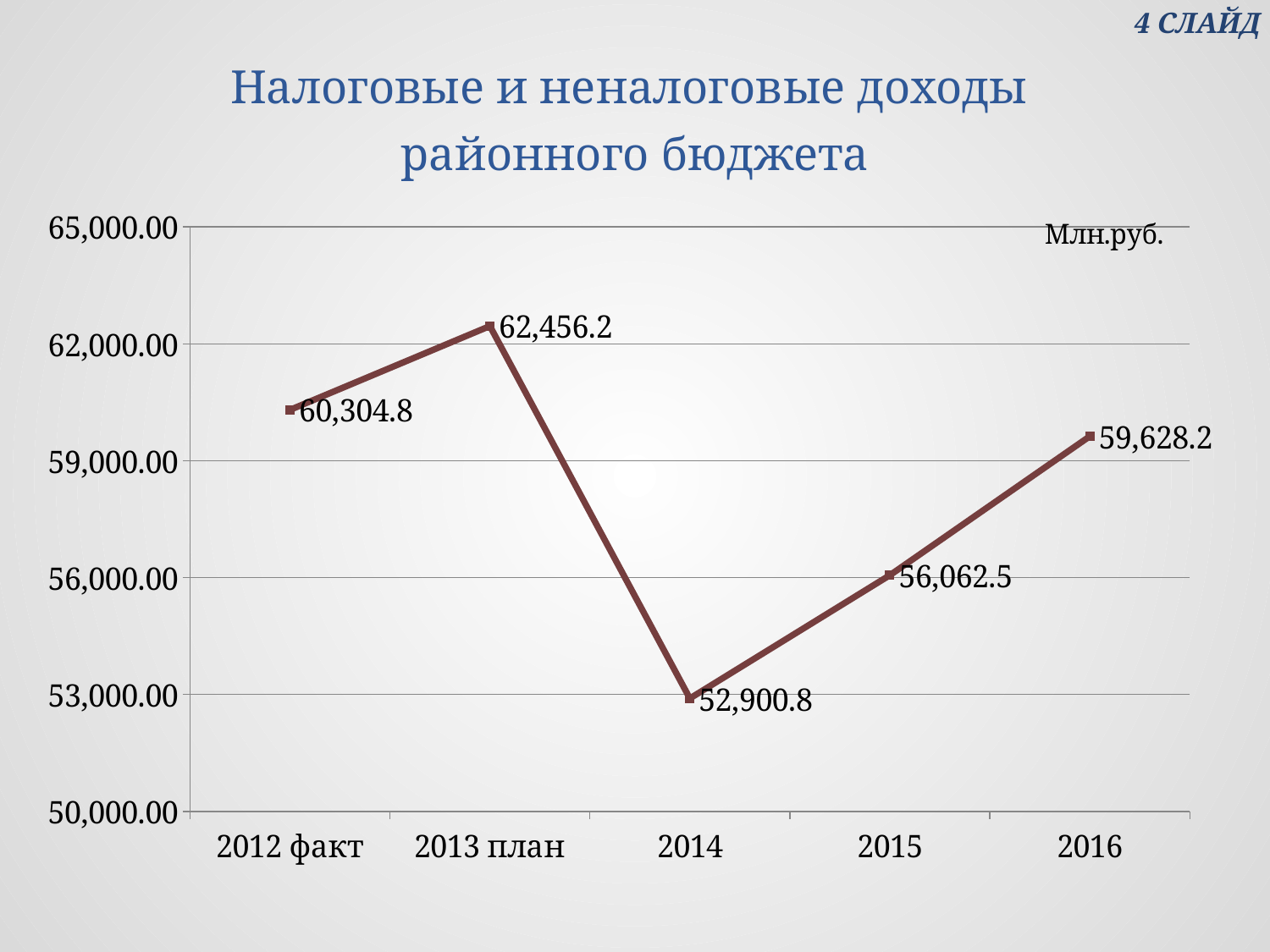
How many data points are plotted on the chart? 5 What is the value for 2012 факт? 60,304.8 What is the value for 2013 план? 62,456.2 What is the value for 2016? 59,628.2 What is the difference between the values for 2013 план and 2014? 9,555.4 Which is larger, the value for 2012 факт or the value for 2016? 2012 факт What is the value for 2014? 52,900.8 What kind of chart is shown on the slide? Line chart Which category has the lowest value? 2014 What is the difference between the values for 2016 and 2015? 3,565.7 What unit is indicated on the chart? Млн.руб. Which category has the highest value? 2013 план